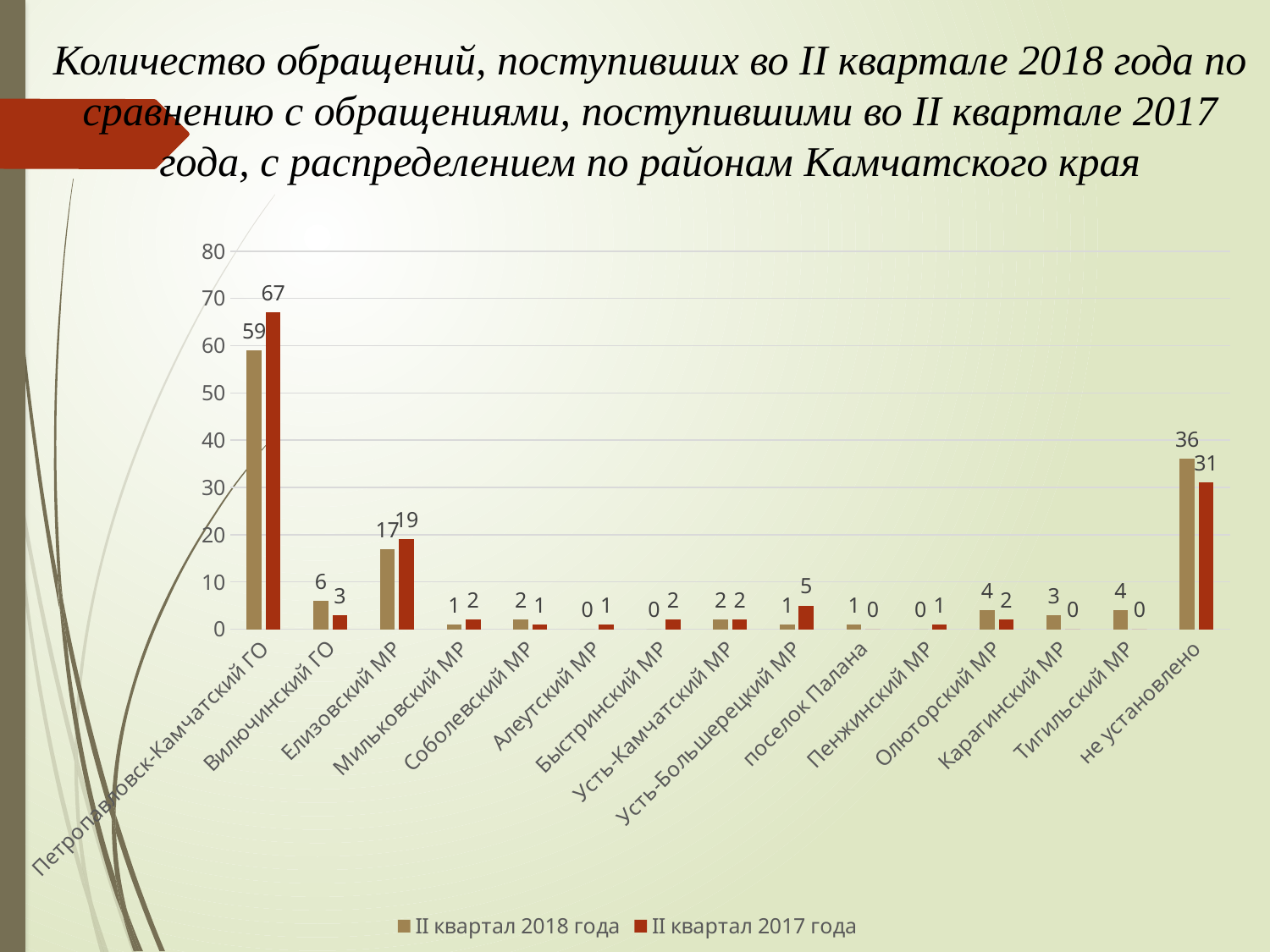
What kind of chart is shown on the slide? Bar chart For Вилючинский ГО, which series has the larger value: II квартал 2018 года or II квартал 2017 года? II квартал 2018 года What is the value for Петропавловск-Камчатский ГО in the II квартал 2018 года series? 59 Which category has the highest value in the II квартал 2017 года series? Петропавловск-Камчатский ГО What is the value for не установлено in the II квартал 2018 года series? 36 What is the value for Усть-Большерецкий МР in the II квартал 2017 года series? 5 How many categories are shown on the x axis? 15 What is the difference between the II квартал 2017 года and II квартал 2018 года values for Петропавловск-Камчатский ГО? 8 What is the difference between the II квартал 2018 года and II квартал 2017 года values for не установлено? 5 What is the value for Петропавловск-Камчатский ГО in the II квартал 2017 года series? 67 How many series does the legend list? 2 For Елизовский МР, which series has the larger value: II квартал 2018 года or II квартал 2017 года? II квартал 2017 года